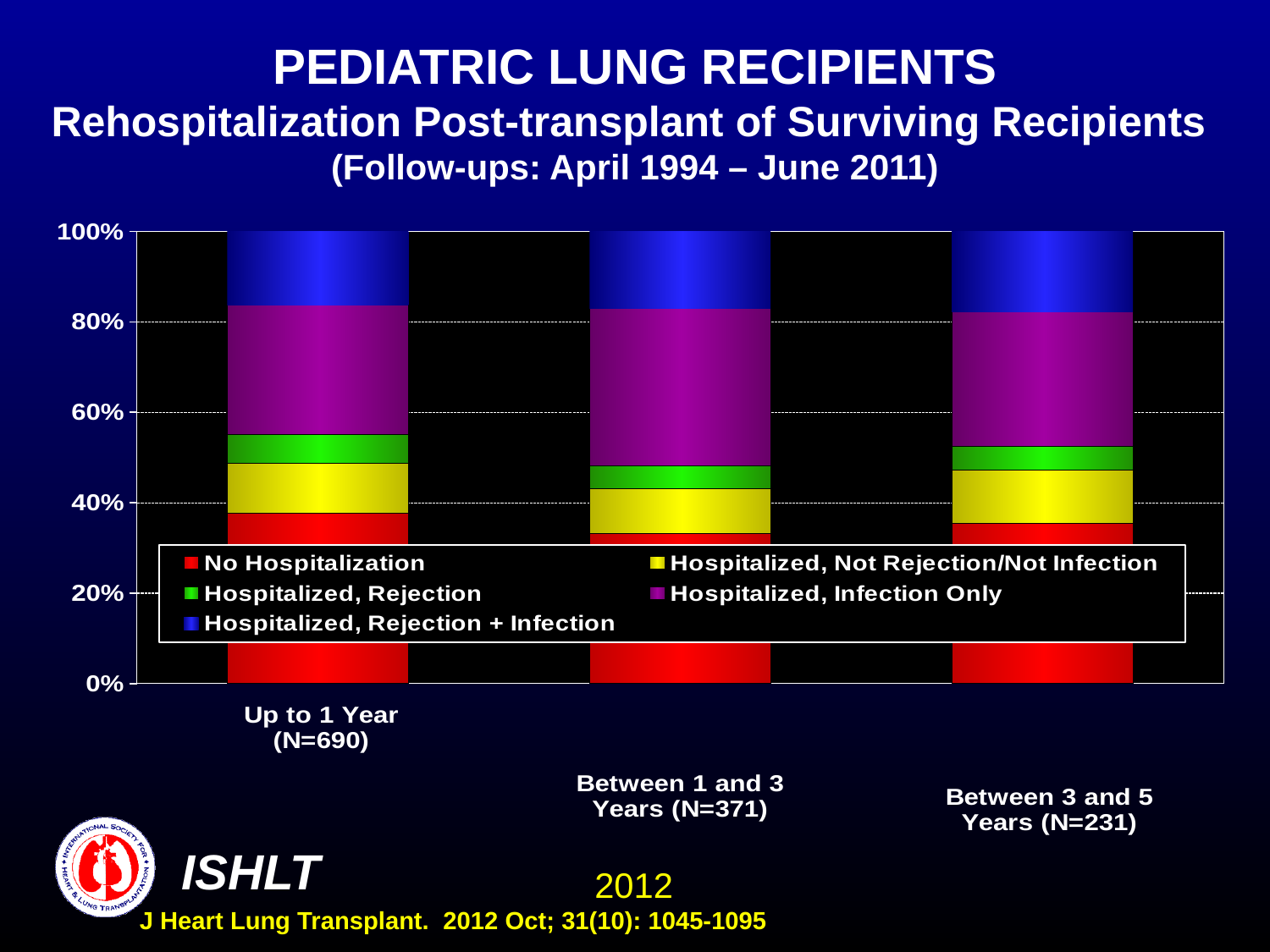
What is the N shown for the Up to 1 Year category? N=690 What does each stacked bar total? 100% Is the top of the Hospitalized, Infection Only segment for Up to 1 Year greater or less than 80%? greater Is the top of the Hospitalized, Rejection segment for Between 1 and 3 Years greater or less than 60%? less How many series does the legend list? 5 Is the top of the Hospitalized, Rejection segment for Up to 1 Year greater or less than 60%? less How many follow-up period categories are plotted on the x axis? 3 What kind of chart is shown on the slide? Stacked bar chart Which series is shown in red in the legend? No Hospitalization